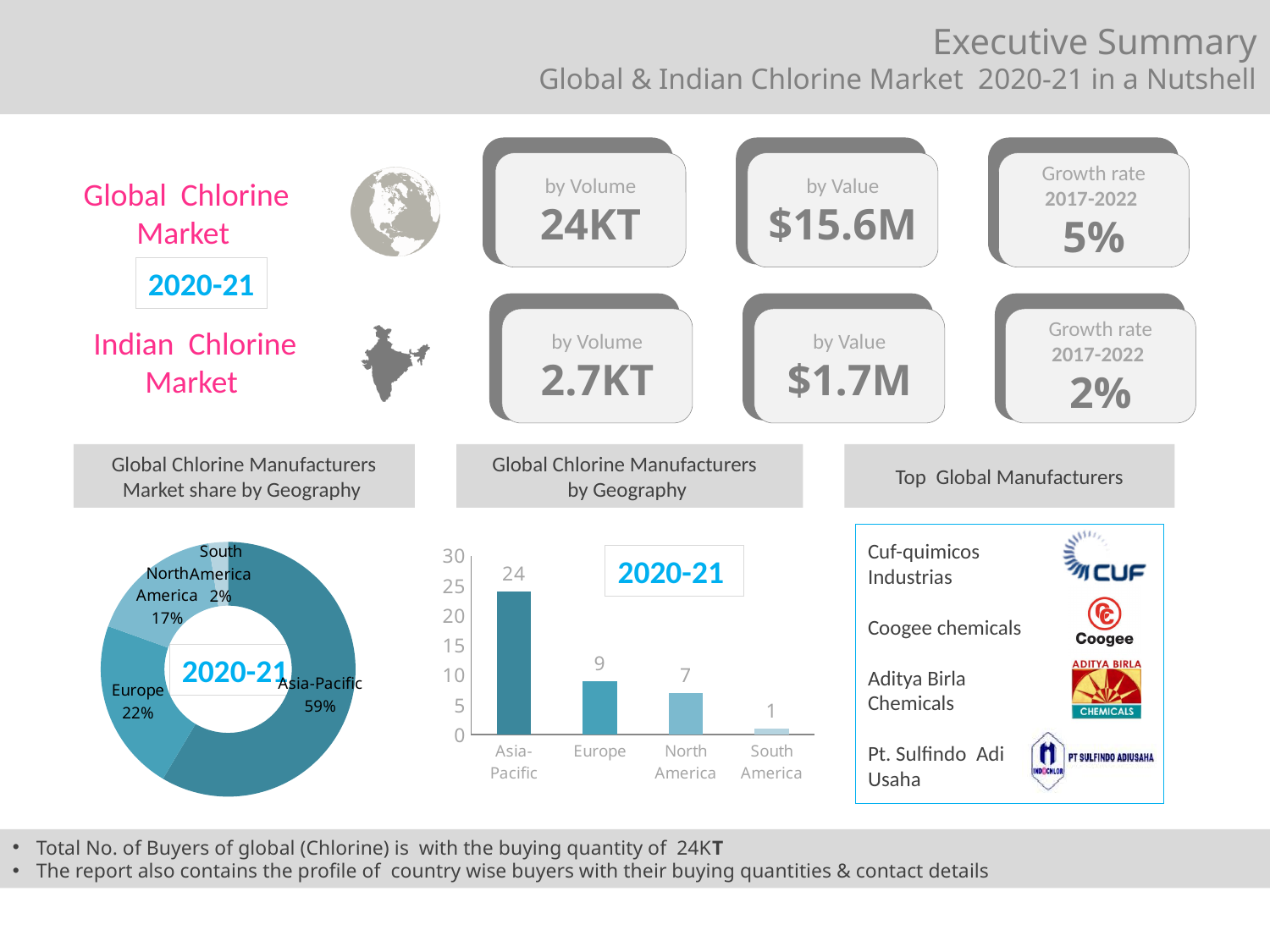
In the 'Global Chlorine Manufacturers by Geography' bar chart, what is the value for Asia-Pacific? 24 In the 'Global Chlorine Manufacturers Market share by Geography' chart, which region has the smallest share? South America In the 'Global Chlorine Manufacturers by Geography' bar chart, do the values rise or fall from left to right? Fall What kind of chart is 'Global Chlorine Manufacturers Market share by Geography'? Doughnut chart What kind of chart is 'Global Chlorine Manufacturers by Geography'? Bar chart In the 'Global Chlorine Manufacturers by Geography' bar chart, what is the difference between the values for Asia-Pacific and North America? 17 In the 'Global Chlorine Manufacturers by Geography' bar chart, which region has the lowest value? South America In the 'Global Chlorine Manufacturers by Geography' bar chart, what is the value for Europe? 9 In the 'Global Chlorine Manufacturers by Geography' bar chart, which is larger, the value for Europe or the value for North America? Europe In the 'Global Chlorine Manufacturers by Geography' bar chart, how many regions are shown? 4 In the 'Global Chlorine Manufacturers Market share by Geography' chart, what is the share for North America? 17% In the 'Global Chlorine Manufacturers Market share by Geography' chart, what share does Asia-Pacific hold? 59%